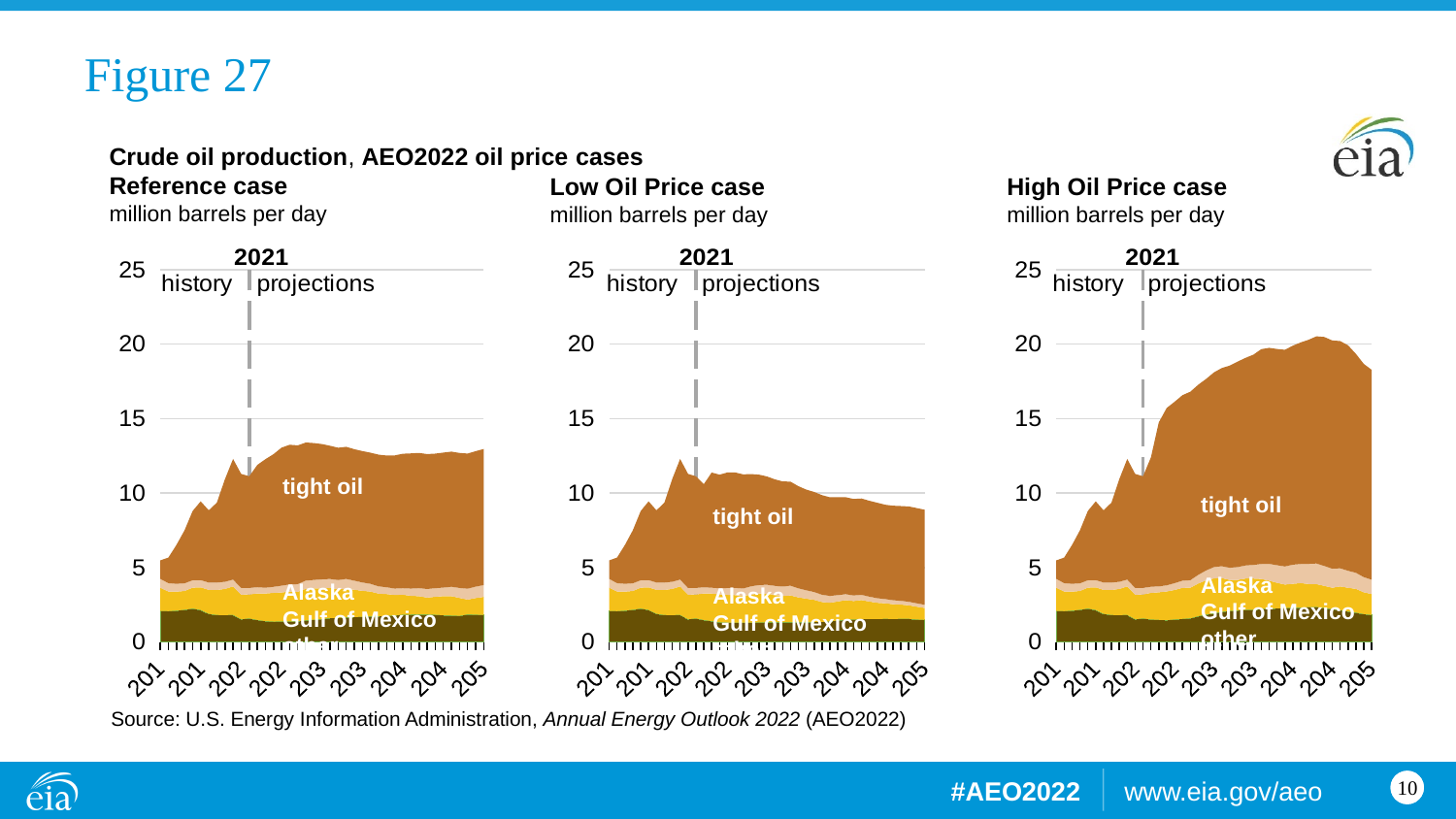
In the High Oil Price case chart, does total crude oil production rise or fall from 2021 to around 2040? rise In the Low Oil Price case chart, is the total crude oil production at the end of the projection period (2050) greater or less than 10 million barrels per day? less What unit is used on the y-axis of the three charts? million barrels per day Which case shows higher total crude oil production in 2050, the High Oil Price case or the Low Oil Price case? High Oil Price case What kind of chart is used for the Reference case? stacked area chart In the Low Oil Price case chart, does total crude oil production rise or fall over the projection period after 2021? fall How many charts are shown on the slide? 3 What year separates history from projections in the charts? 2021 In the Reference case chart, is the total crude oil production at the end of the projection period (2050) greater or less than 10 million barrels per day? greater In the Reference case chart, is the total crude oil production at the end of the projection period (2050) greater or less than 15 million barrels per day? less Which production source makes up the largest area in all three charts? tight oil